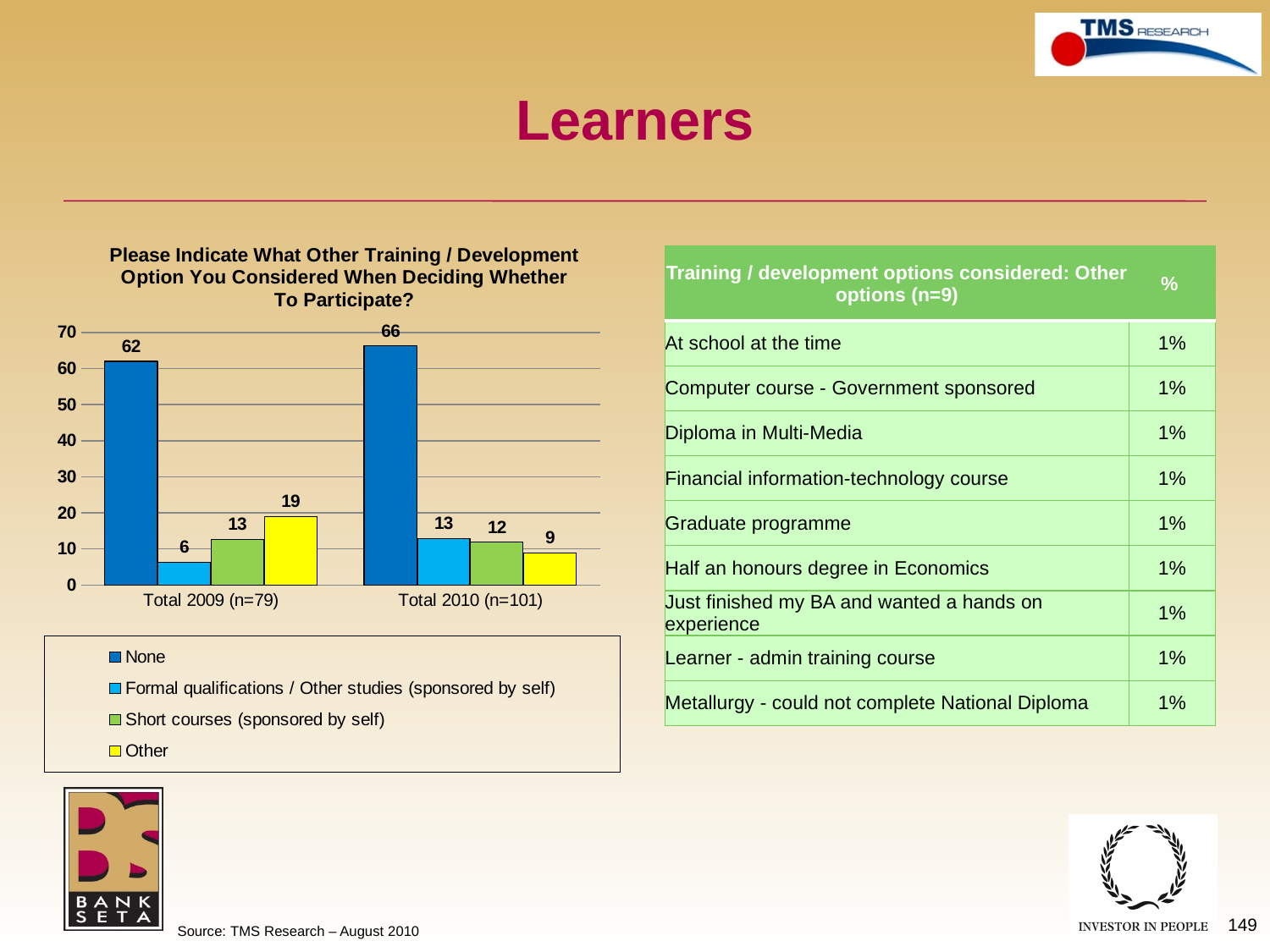
Which series has the lowest value in Total 2009 (n=79)? Formal qualifications / Other studies (sponsored by self) What is the value for Other in Total 2010 (n=101)? 9 What is the value for Short courses (sponsored by self) in Total 2010 (n=101)? 12 How many series does the legend list? 4 What is the difference between the None values for Total 2010 (n=101) and Total 2009 (n=79)? 4 What is the value for Formal qualifications / Other studies (sponsored by self) in Total 2009 (n=79)? 6 What kind of chart is shown on the slide? Bar chart How many categories are shown on the x axis? 2 Does the value for Other rise or fall from Total 2009 (n=79) to Total 2010 (n=101)? Fall Which is larger: Other in Total 2009 (n=79) or Other in Total 2010 (n=101)? Total 2009 (n=79) What is the value for None in Total 2009 (n=79)? 62 Which series has the highest value in Total 2010 (n=101)? None